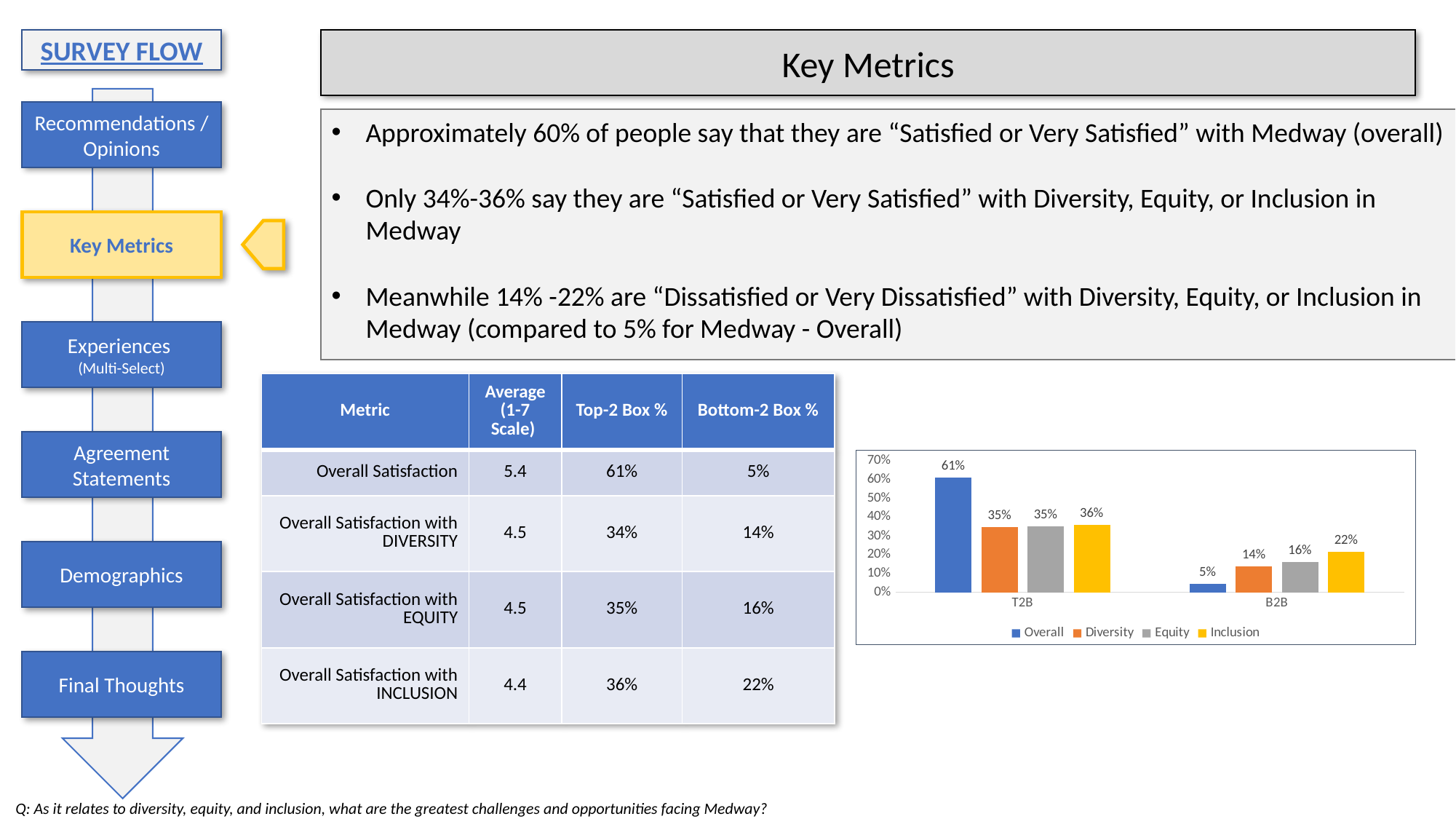
How many series does the legend list? 4 Which series has the highest value in the T2B group? Overall What is the difference between the Inclusion value and the Equity value in the B2B group? 6% What is the value for Overall in the T2B group? 61% What kind of chart is shown? Bar chart How many category groups are shown on the x axis? 2 Which is larger in the B2B group, Equity or Diversity? Equity Which series has the lowest value in the B2B group? Overall What is the difference between the Overall value and the Inclusion value in the T2B group? 25% What is the value for Inclusion in the B2B group? 22% What is the value for Diversity in the B2B group? 14% What colour represents the Inclusion series? Yellow